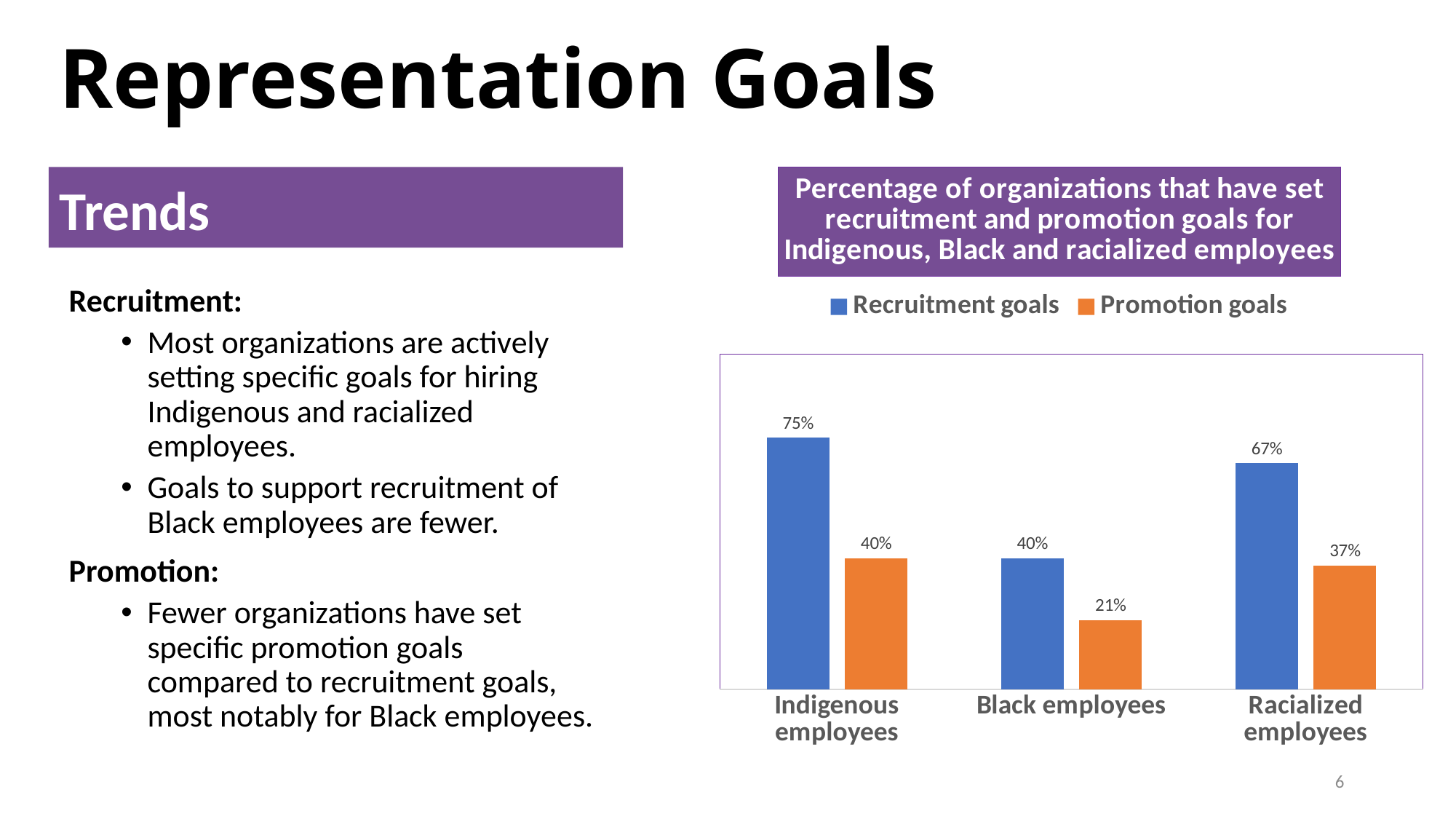
How many employee groups are shown on the x axis of the chart? 3 What is the difference between recruitment goals for Racialized employees and recruitment goals for Black employees? 27 percentage points What kind of chart is shown on the slide? Bar chart Which is larger: promotion goals for Indigenous employees or promotion goals for Racialized employees? Promotion goals for Indigenous employees Which colour represents Promotion goals in the chart? Orange Which employee group has the lowest percentage of organizations with promotion goals? Black employees What is the value for promotion goals for Racialized employees? 37% What percentage of organizations have set promotion goals for Black employees? 21% What percentage of organizations have set recruitment goals for Indigenous employees? 75% What is the difference between recruitment goals and promotion goals for Indigenous employees? 35 percentage points How many series does the chart legend list? 2 Which employee group has the highest percentage of organizations with recruitment goals? Indigenous employees